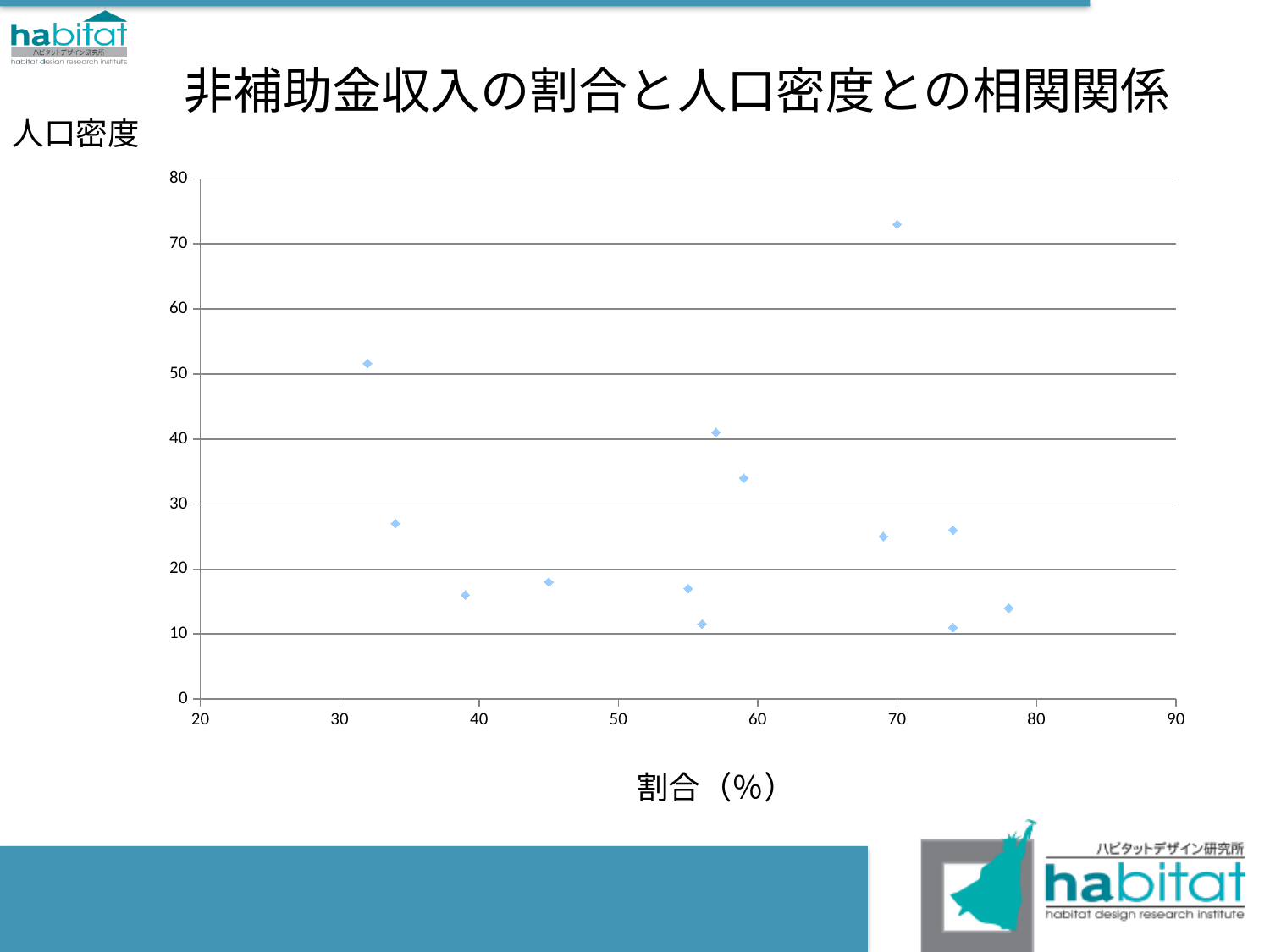
What is the title of the chart? 非補助金収入の割合と人口密度との相関関係 What is the label of the x axis? 割合（%） Is the population density of the highest point on the chart greater or less than 70? greater What is the maximum value shown on the y axis? 80 Which has the higher population density: the point at a ratio of about 32% or the point at a ratio of about 34%? the point at about 32% Is the population density of the point at a ratio of about 32% greater or less than 50? greater Is the population density of the point at a ratio of about 78% greater or less than 20? less What kind of chart is shown on the slide? scatter chart How many data points are plotted on the chart? 13